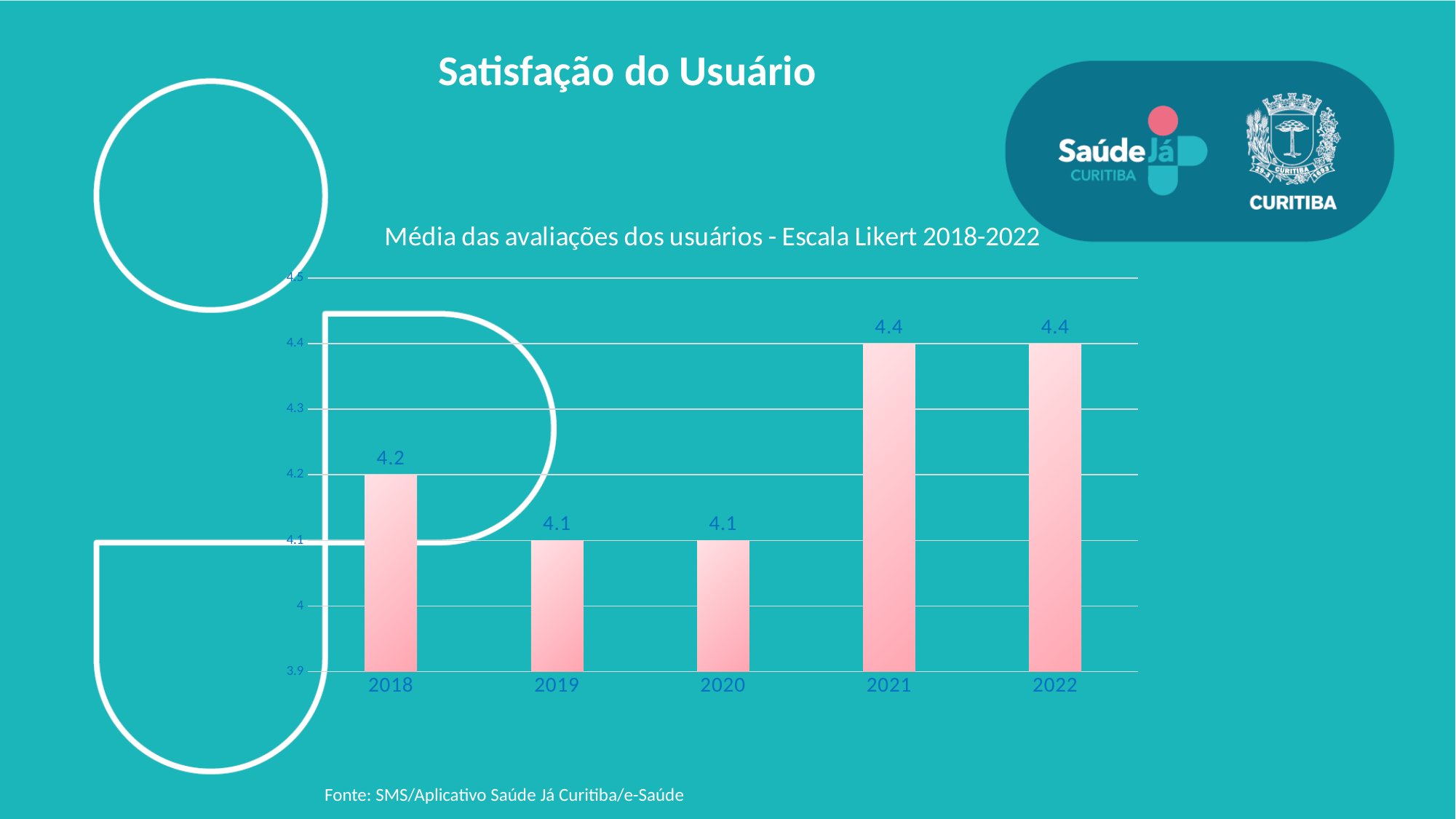
What is the difference between the ratings for 2018 and 2020? 0.1 What is the average user rating for 2018? 4.2 What is the average user rating for 2020? 4.1 Do the ratings rise or fall from 2020 to 2021? rise What is the title of the chart? Média das avaliações dos usuários - Escala Likert 2018-2022 What kind of chart is shown on the slide? bar chart Is the value for 2021 greater or less than 4.3? greater What is the difference between the ratings for 2021 and 2019? 0.3 What is the average user rating for 2022? 4.4 How many years are shown on the x axis? 5 Is the value for 2019 greater or less than 4.2? less Which year has the lowest average rating, 2018 or 2019? 2019